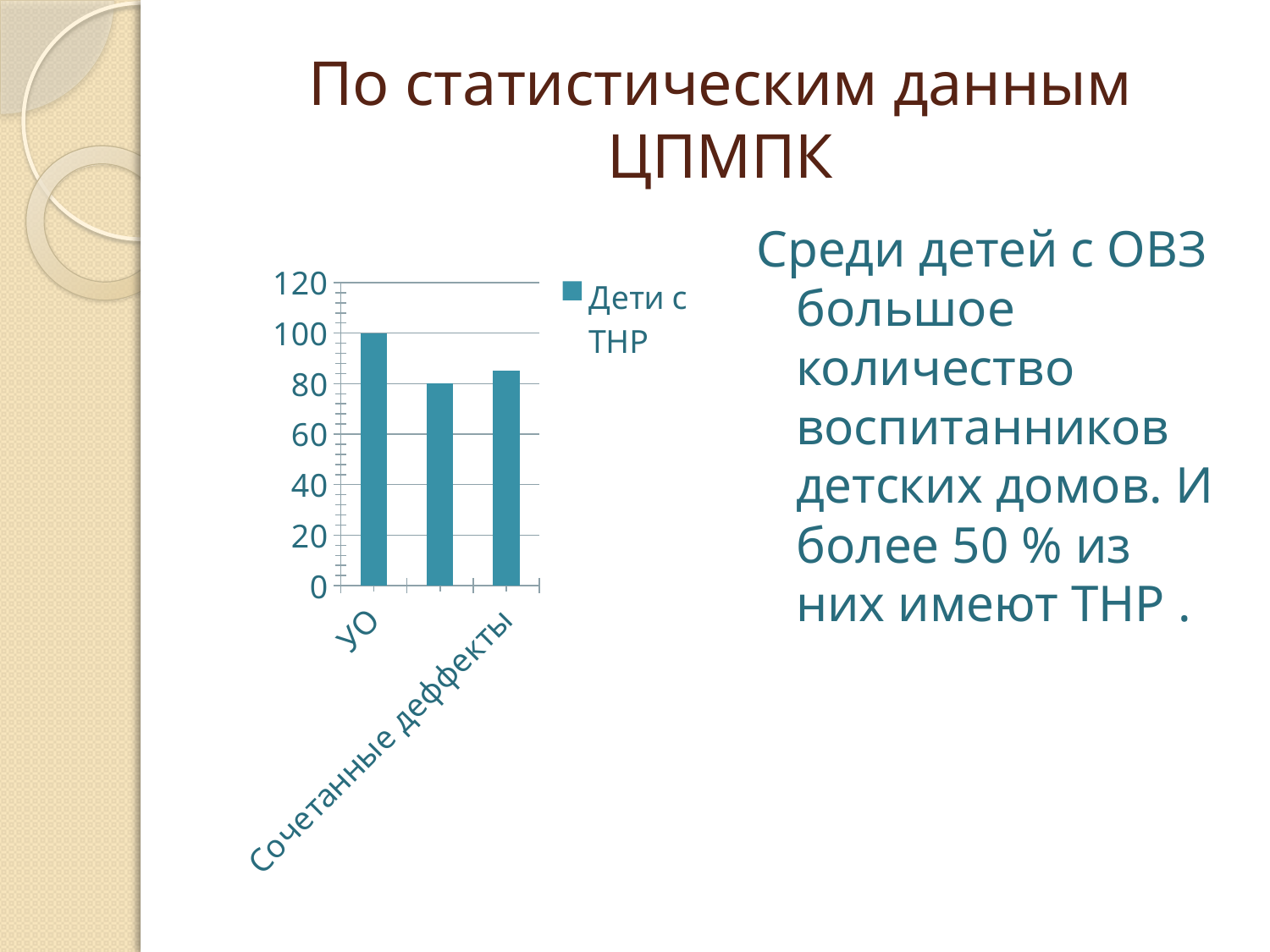
What is the highest value shown on the vertical axis of the chart? 120 How many bars are plotted in the chart? 3 Is the value for Сочетанные деффекты greater or less than 100? less Which category has the highest value in the chart? УО What is the value for УО? 100 Is the value for УО greater or less than 60? greater How many series does the chart legend list? 1 What is the name of the series shown in the chart legend? Дети с ТНР Which is larger, the value for УО or the value for Сочетанные деффекты? УО Is the value for Сочетанные деффекты greater or less than 80? greater What type of chart is shown on the slide? bar chart